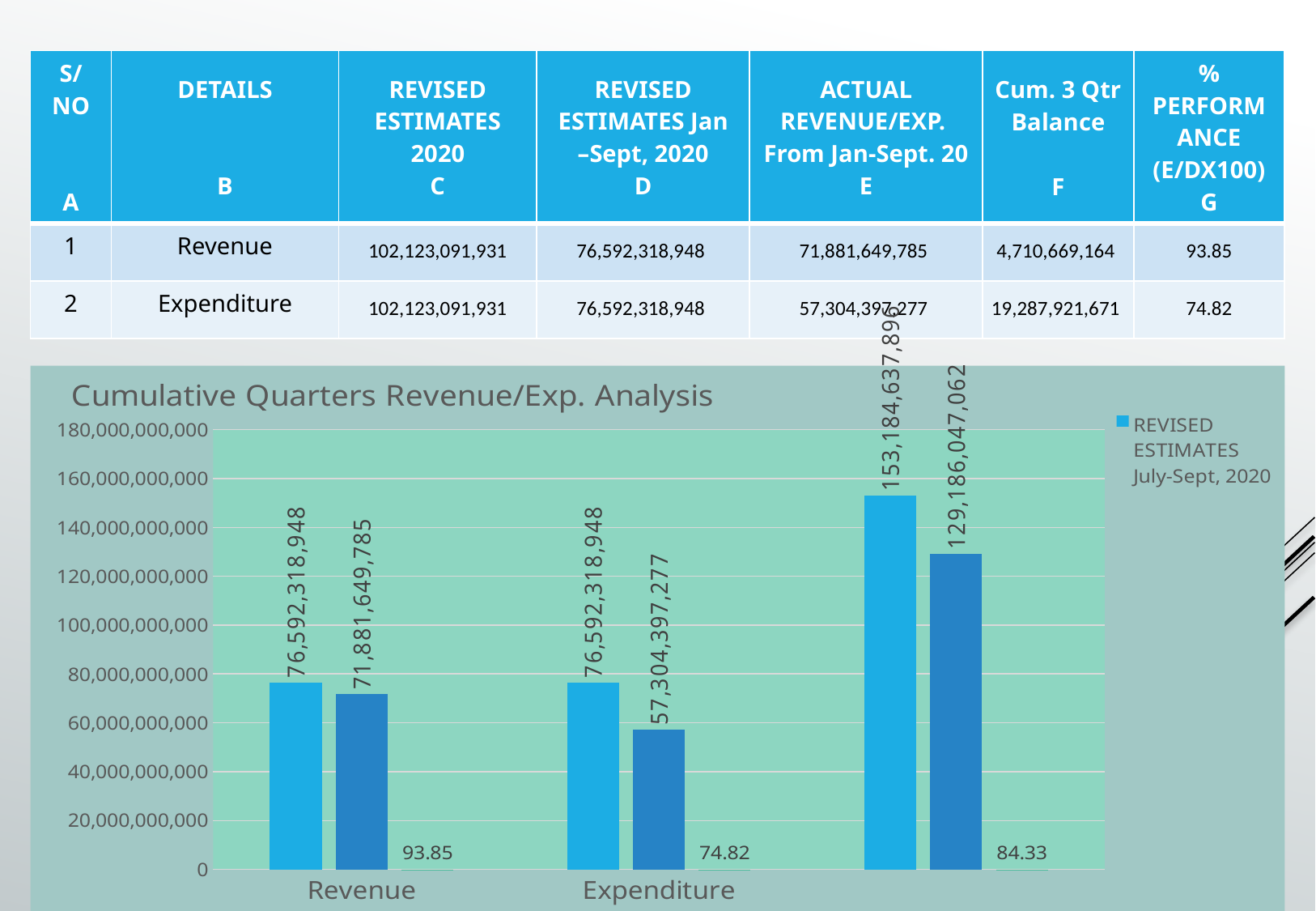
What is the value of the light blue bar for Expenditure? 76,592,318,948 What is the value of the dark blue bar for Revenue? 71,881,649,785 What is the title of the chart? Cumulative Quarters Revenue/Exp. Analysis What is the value of the dark blue bar for Expenditure? 57,304,397,277 Is the value of the dark blue bar for Expenditure greater or less than 60,000,000,000? less What is the difference between the light blue bar and the dark blue bar for Expenditure? 19,287,921,671 What is the value of the light blue bar for Revenue? 76,592,318,948 Which category has the larger dark blue bar, Revenue or Expenditure? Revenue What percentage label is shown at the base of the Revenue group? 93.85 What series name does the chart legend show? REVISED ESTIMATES July-Sept, 2020 What type of chart is shown on the slide? bar chart What is the value of the tallest bar in the chart? 153,184,637,896